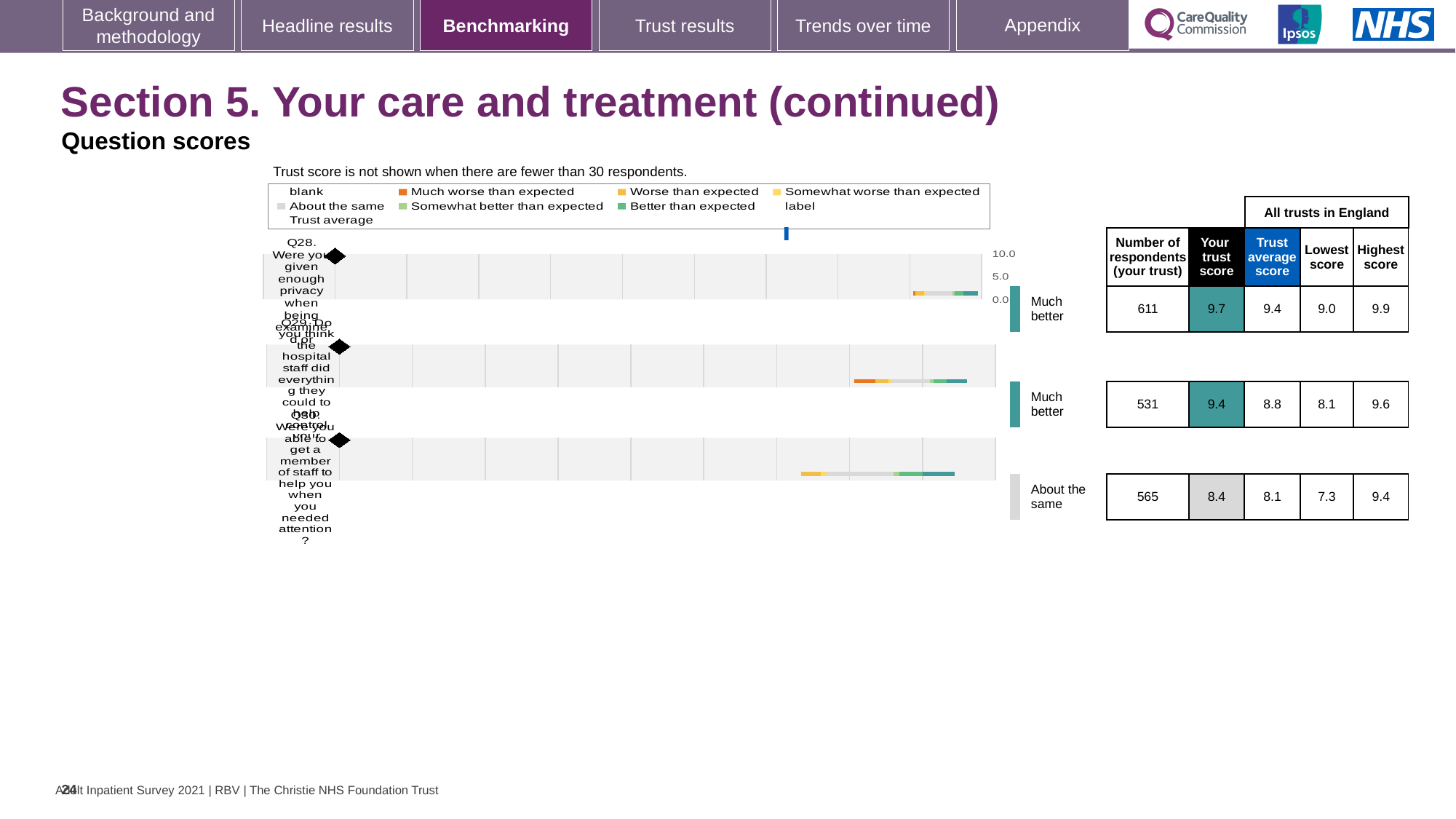
How many questions are plotted on the chart? 3 What is the highest score across all trusts in England for Q30? 9.4 Is your trust score for Q28 greater or less than 5.0 on the chart axis? greater What is the 'Your trust score' for Q28 (Were you given enough privacy when being examined or treated)? 9.7 What is the difference between your trust score and the trust average score for Q28? 0.3 Which question has the highest 'Your trust score'? Q28 What benchmark category label is shown for Q30? About the same What is the trust average score for Q29 (Do you think the hospital staff did everything they could to help control your pain)? 8.8 For Q29, which is larger: your trust score or the trust average score? Your trust score Which question has the lowest 'Your trust score'? Q30 How many respondents from your trust answered Q30 (Were you able to get a member of staff to help you when you needed attention)? 565 What is the difference between the highest score and the lowest score for Q29? 1.5